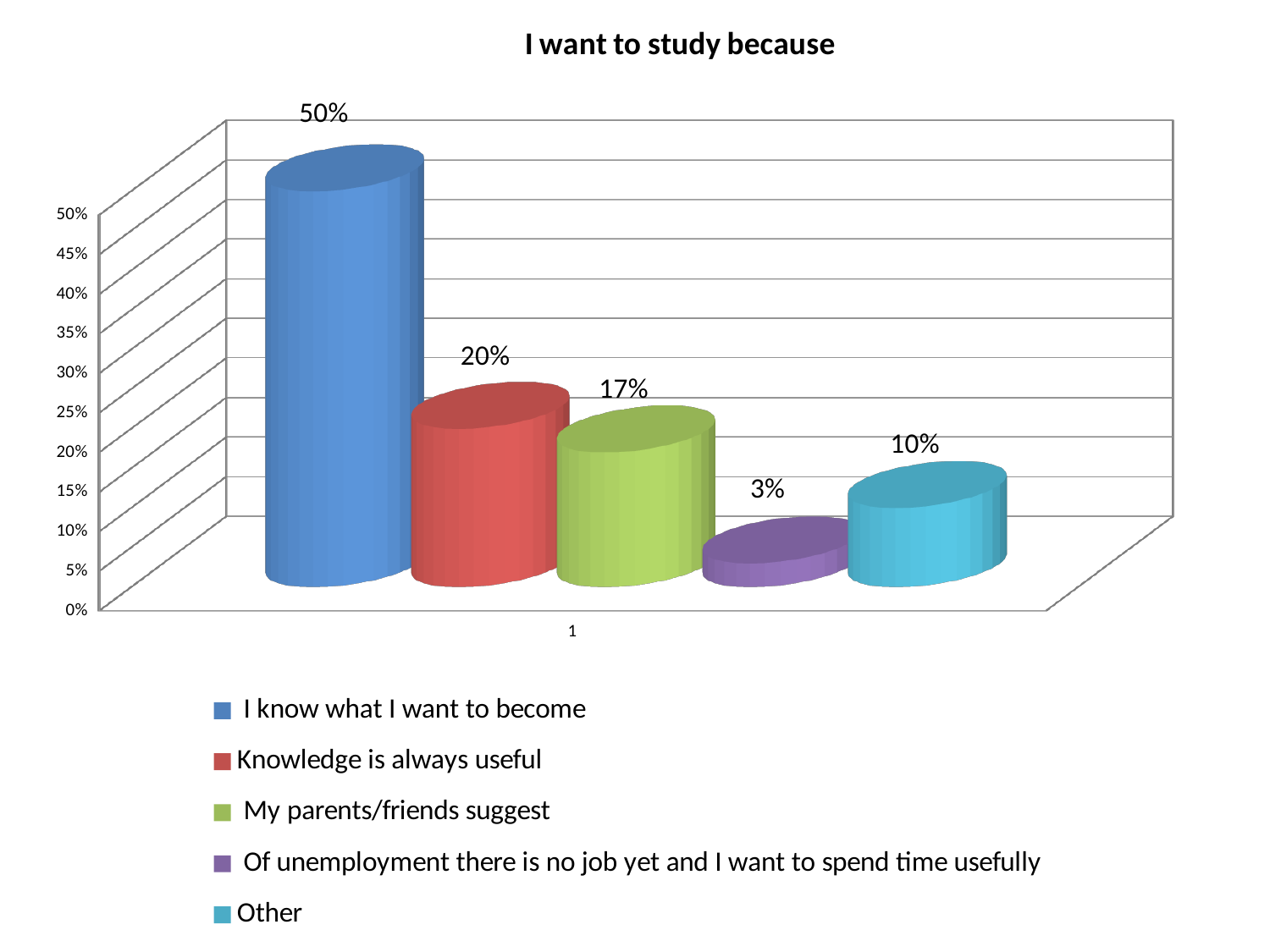
What is the value for "My parents/friends suggest"? 17% Which reason has the highest value? I know what I want to become How many series does the legend list? 5 What is the value for "Other"? 10% Which is larger, "My parents/friends suggest" or "Other"? My parents/friends suggest What is the value for "Of unemployment there is no job yet and I want to spend time usefully"? 3% What is the value for "I know what I want to become"? 50% Which reason has the lowest value? Of unemployment there is no job yet and I want to spend time usefully What is the value for "Knowledge is always useful"? 20% What is the title of the chart? I want to study because What kind of chart is shown on the slide? Bar chart What is the difference between "I know what I want to become" and "Knowledge is always useful"? 30%